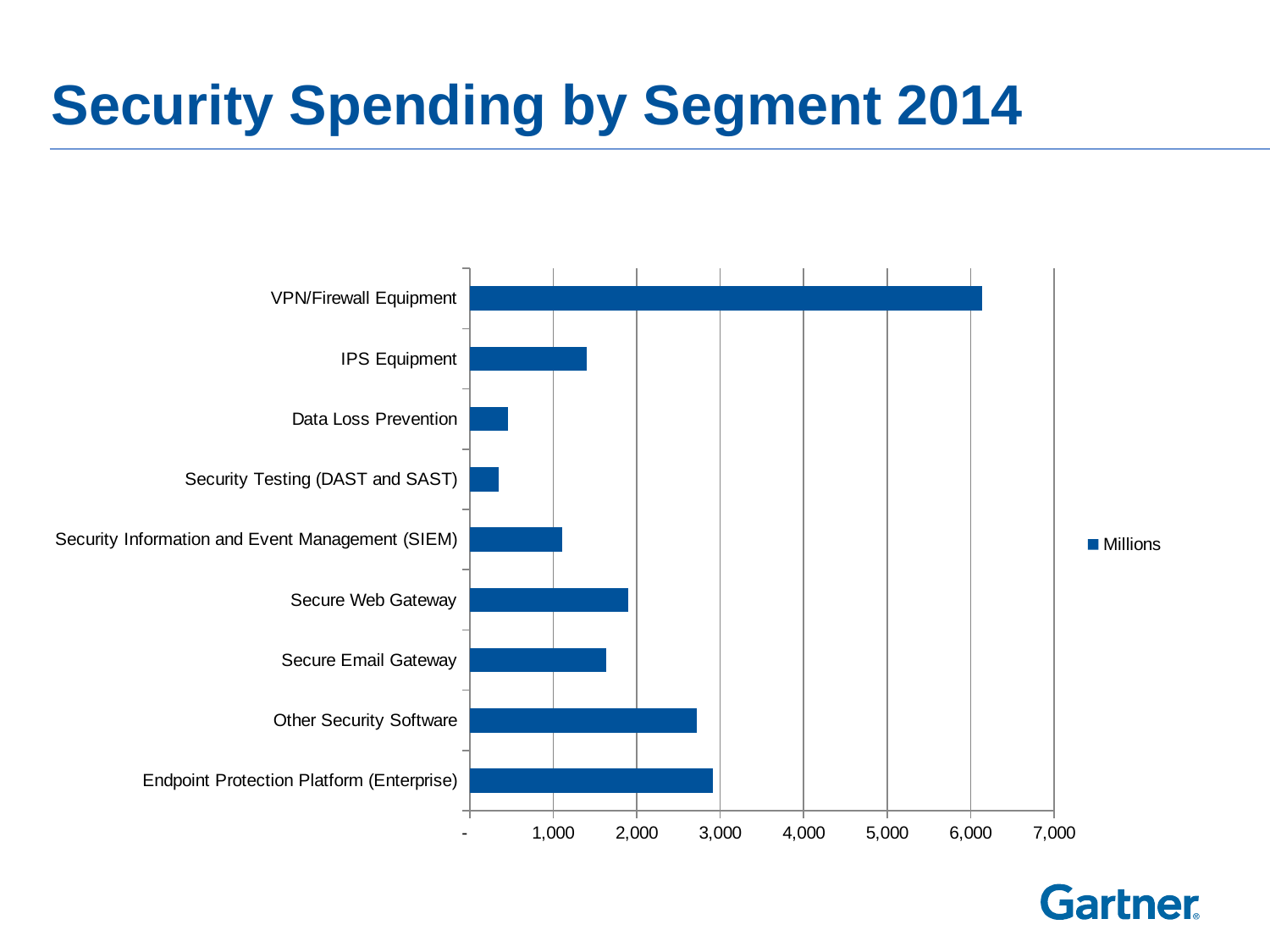
Is the value for VPN/Firewall Equipment greater or less than 5,000? greater What is the name of the series shown in the legend? Millions What is the title of the chart? Security Spending by Segment 2014 Is the value for IPS Equipment greater or less than 1,000? greater Which segment has the highest security spending? VPN/Firewall Equipment Which is larger, the value for Endpoint Protection Platform (Enterprise) or the value for Secure Web Gateway? Endpoint Protection Platform (Enterprise) How many series does the legend list? 1 What type of chart is shown on the slide? Bar chart Is the value for Data Loss Prevention greater or less than 1,000? less Which is larger, the value for Other Security Software or the value for Secure Email Gateway? Other Security Software How many segments (categories) are plotted in the chart? 9